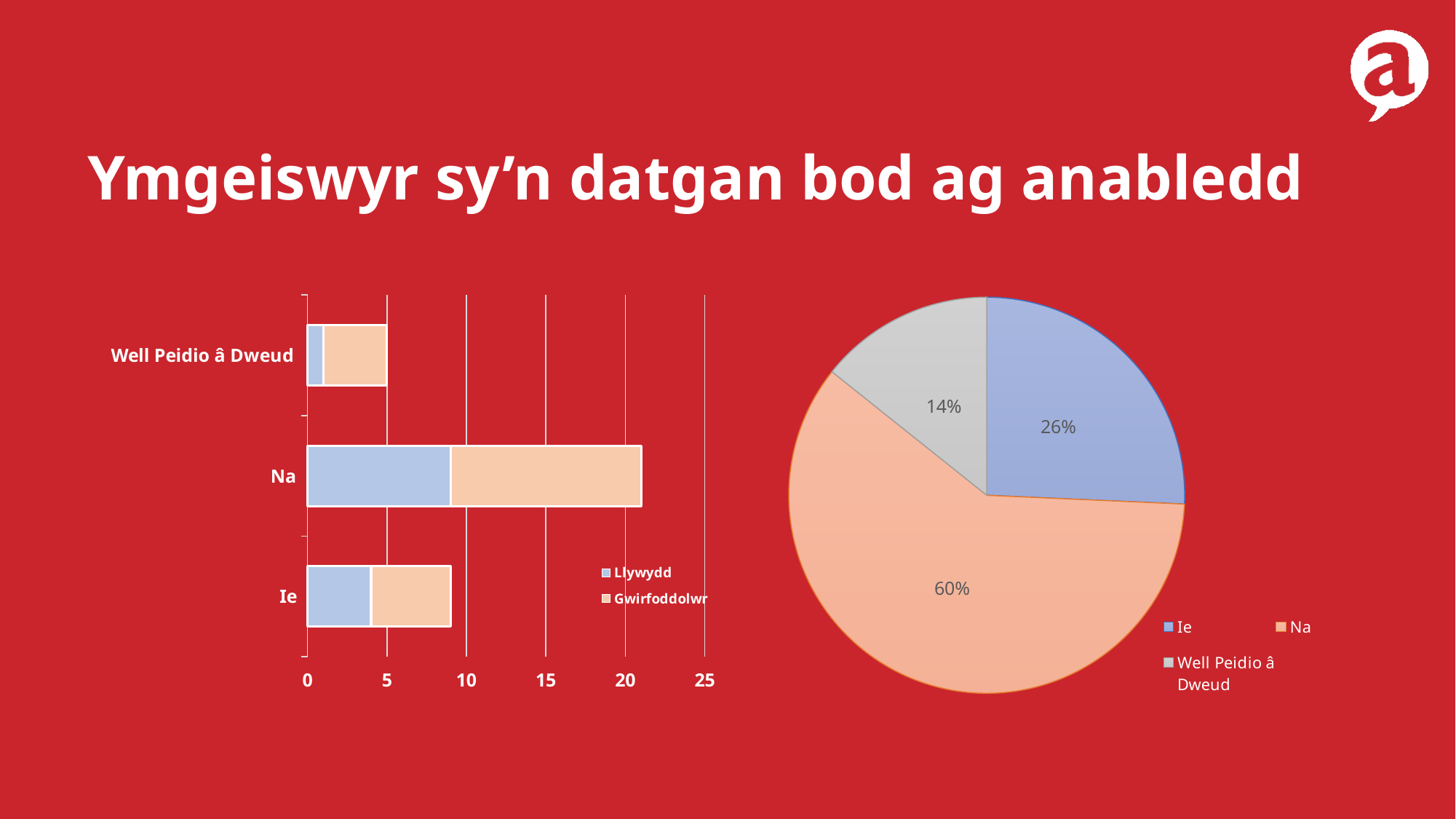
In the pie chart on the right, which category has the largest slice? Na In the bar chart on the left, which category has the longer total bar, Na or Ie? Na In the pie chart on the right, what is the difference in percentage points between the Na slice and the Ie slice? 34% In the bar chart on the left, is the total length of the Na bar greater or less than 20? greater In the bar chart on the left, how many series does the legend list? 2 In the pie chart on the right, what share does the Well Peidio â Dweud slice have? 14% In the pie chart on the right, which category has the smallest slice? Well Peidio â Dweud In the pie chart on the right, what share does the Na slice have? 60% What kind of chart is the chart on the left of the slide? bar chart In the bar chart on the left, how many categories are shown on the vertical axis? 3 In the pie chart on the right, what share does the Ie slice have? 26% What kind of chart is the chart on the right of the slide? pie chart